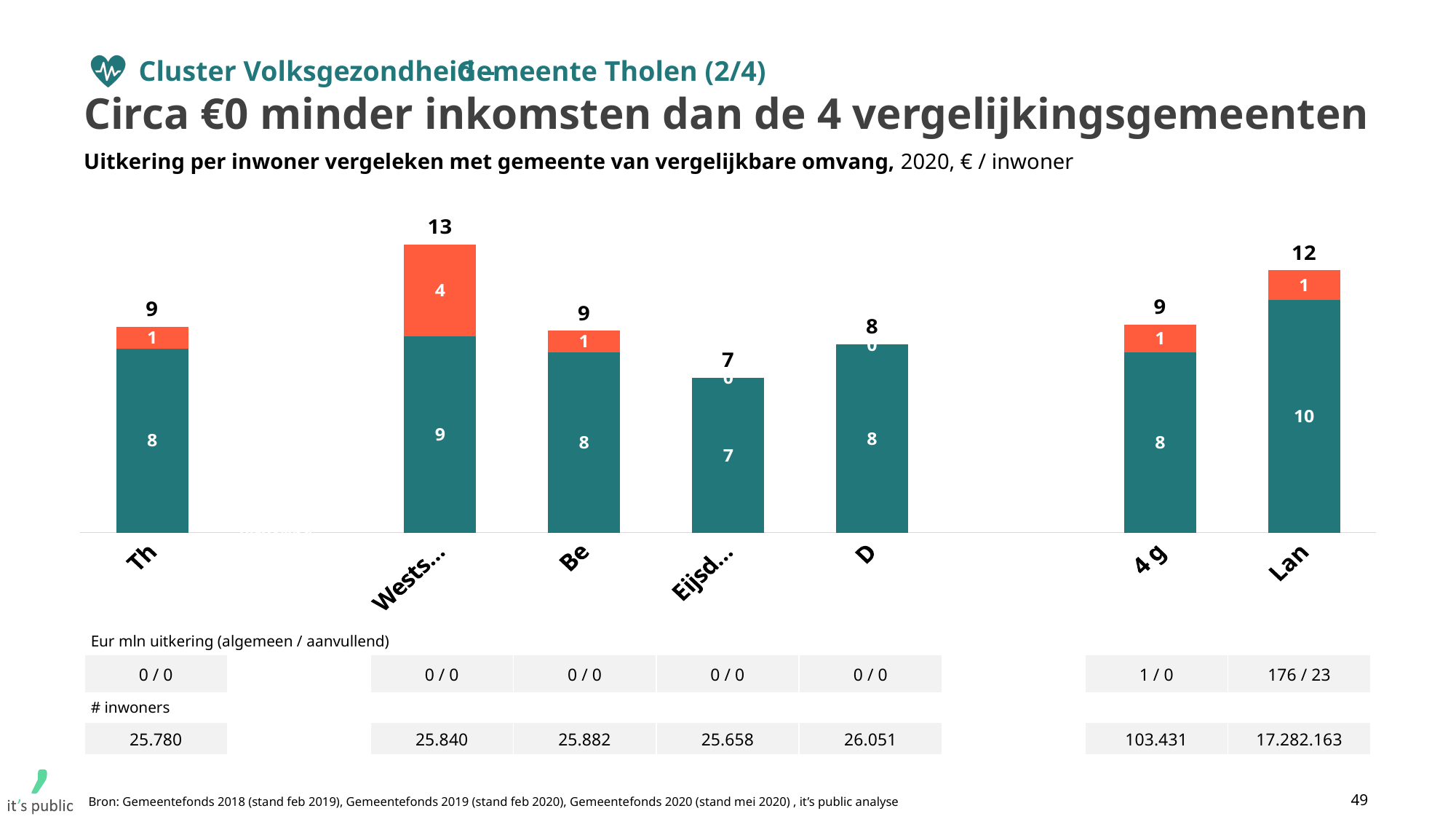
What is the number of inhabitants (# inwoners) listed under the bar for Th? 25.780 What is the value of the teal (lower) segment of the bar for Lan? 10 How many bars are shown in the chart? 7 What is the value of the orange (upper) segment of the bar for Wests...? 4 Which has a larger total value, Lan or 4 g? Lan Which category has the lowest total value? Eijsd... What is the difference between the total for Wests... and the total for Th? 4 What is the total value shown above the bar for Wests...? 13 What kind of chart is shown on the slide? Stacked bar chart What is the total value shown above the bar for Lan? 12 What is the value of the teal (lower) segment of the bar for Th? 8 Which category has the highest total value? Wests...